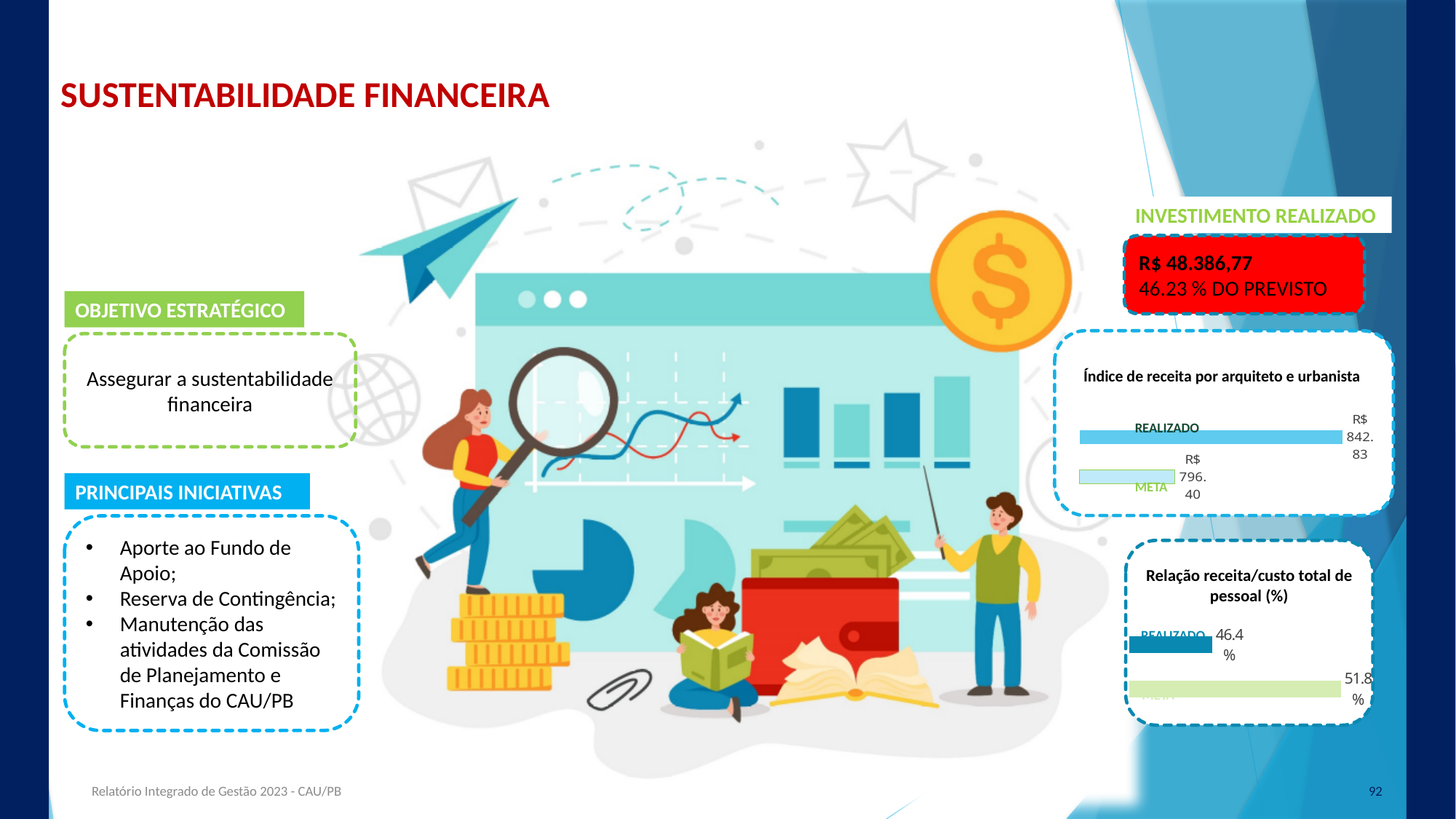
In the chart 'Índice de receita por arquiteto e urbanista', how many bars are plotted? 2 In the chart 'Relação receita/custo total de pessoal (%)', what is the value for META? 51.8% In the chart 'Relação receita/custo total de pessoal (%)', what is the value for REALIZADO? 46.4% In the chart 'Índice de receita por arquiteto e urbanista', what is the value for REALIZADO? R$ 842.83 In the chart 'Índice de receita por arquiteto e urbanista', what is the difference between the REALIZADO and META values? R$ 46.43 In the chart 'Relação receita/custo total de pessoal (%)', which category has the lower value? REALIZADO In the chart 'Índice de receita por arquiteto e urbanista', which category has the higher value, REALIZADO or META? REALIZADO In the chart 'Relação receita/custo total de pessoal (%)', what is the difference between the META and REALIZADO values? 5.4% In the chart 'Índice de receita por arquiteto e urbanista', what is the value for META? R$ 796.40 What is the title of the lower chart on the right side of the slide? Relação receita/custo total de pessoal (%) What kind of chart is 'Índice de receita por arquiteto e urbanista'? Bar chart In the chart 'Relação receita/custo total de pessoal (%)', how many categories are shown? 2